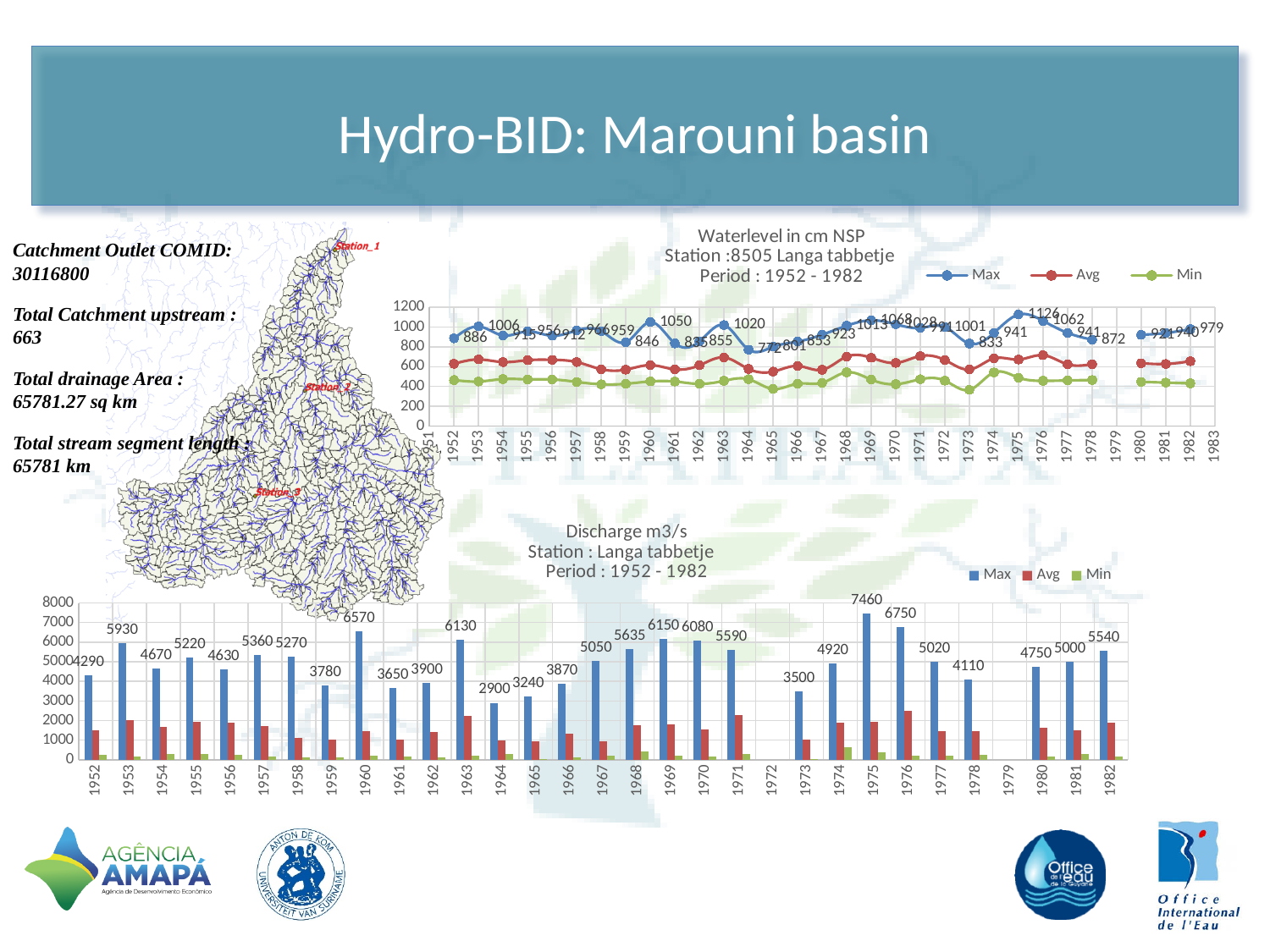
In the Waterlevel in cm NSP chart, what is the highest value of the Max series? 1126 In the Discharge m3/s chart, what is the Max discharge value for 1964? 2900 In the Discharge m3/s chart, which year has the highest Max discharge? 1975 In the Discharge m3/s chart, which year has a larger Max discharge, 1960 or 1963? 1960 In the Discharge m3/s chart, what is the difference between the Max discharge in 1975 and in 1976? 710 What kind of chart is the Discharge m3/s chart? bar chart In the Discharge m3/s chart, what is the Max discharge value for 1975? 7460 How many series does the legend of the Discharge m3/s chart list? 3 What kind of chart is the Waterlevel in cm NSP chart? line chart In the Discharge m3/s chart, is the Avg discharge for 1976 greater or less than 3000? less In the Waterlevel in cm NSP chart, is the Min water level for 1965 greater or less than 600? less In the Discharge m3/s chart, which year has the lowest labelled Max discharge? 1964